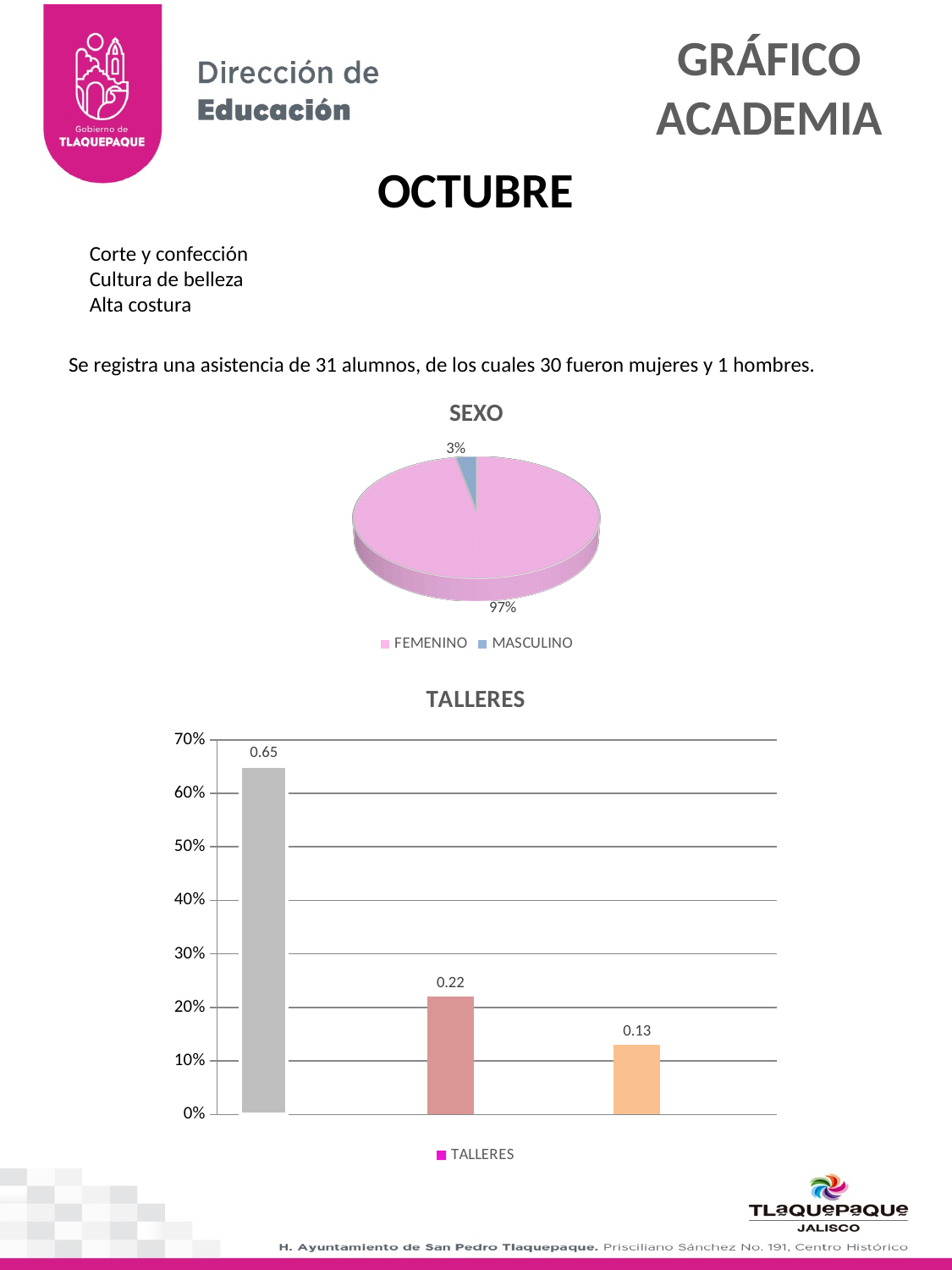
In the TALLERES chart, what is the data label on the middle bar? 0.22 In the SEXO pie chart, what share is FEMENINO? 97% What kind of chart is the TALLERES chart? bar chart How many bars are plotted in the TALLERES chart? 3 What kind of chart is the SEXO chart? pie chart In the TALLERES chart, what is the data label on the rightmost bar? 0.13 In the TALLERES chart, what is the difference between the leftmost bar (0.65) and the middle bar (0.22)? 0.43 In the TALLERES chart, what is the data label on the leftmost bar? 0.65 How many entries does the legend of the SEXO chart list? 2 In the SEXO pie chart, which category has the largest slice? FEMENINO In the TALLERES chart, do the bar values rise or fall from left to right? fall In the SEXO pie chart, what share is MASCULINO? 3%